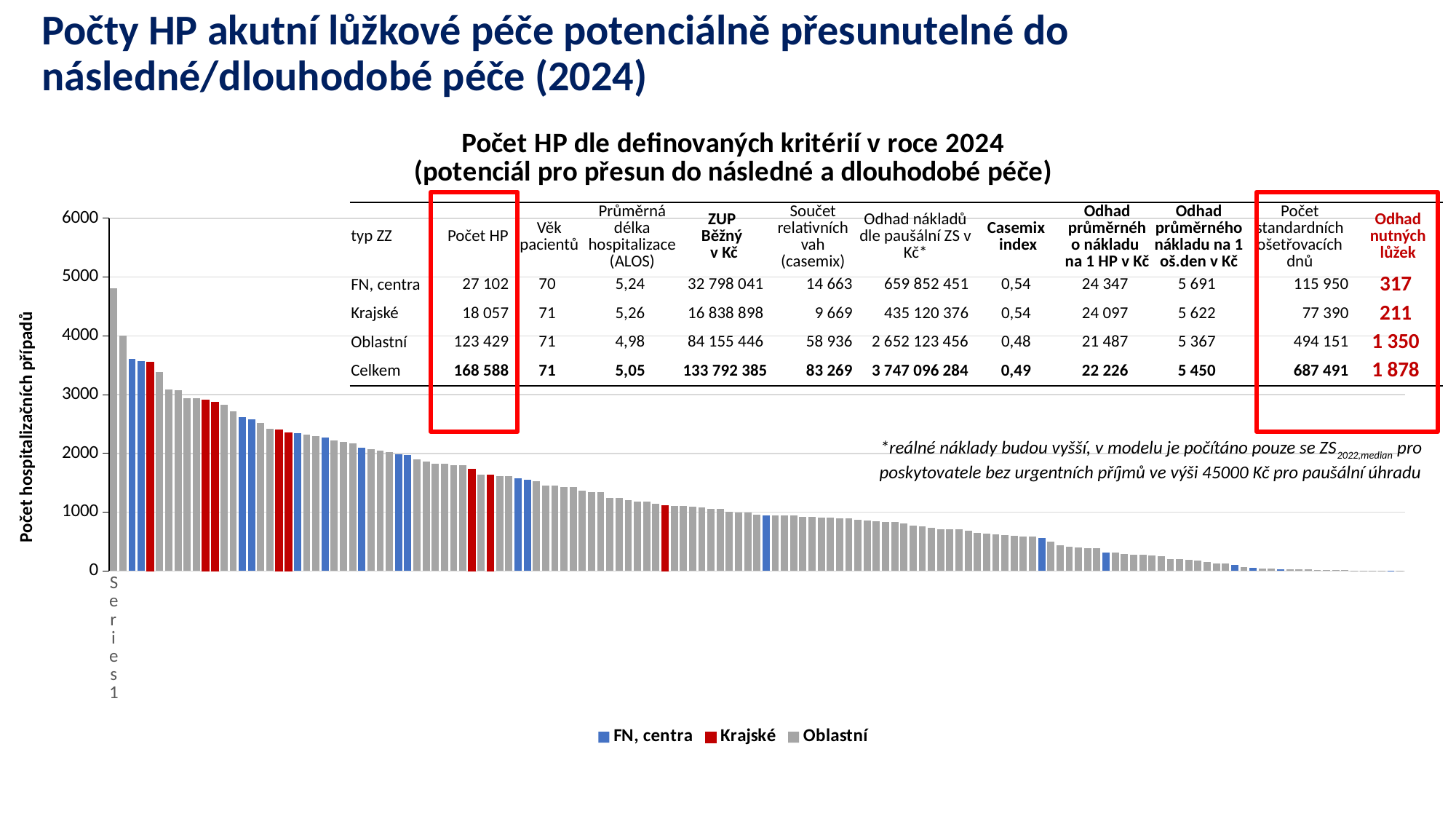
What are the three series named in the chart legend? FN, centra; Krajské; Oblastní How many series does the chart legend list? 3 What is the title of the vertical axis of the chart? Počet hospitalizačních případů Is the value of the tallest Krajské (red) bar greater or less than 4000? less What is the highest value shown on the vertical axis of the chart? 6000 Which series does the tallest bar in the chart belong to? Oblastní Is the value of the tallest FN, centra (blue) bar greater or less than 3000? greater Is the value of the tallest bar in the chart greater or less than 4000? greater Do the bar values rise or fall from left to right along the x axis? fall What kind of chart is shown on the slide? bar chart